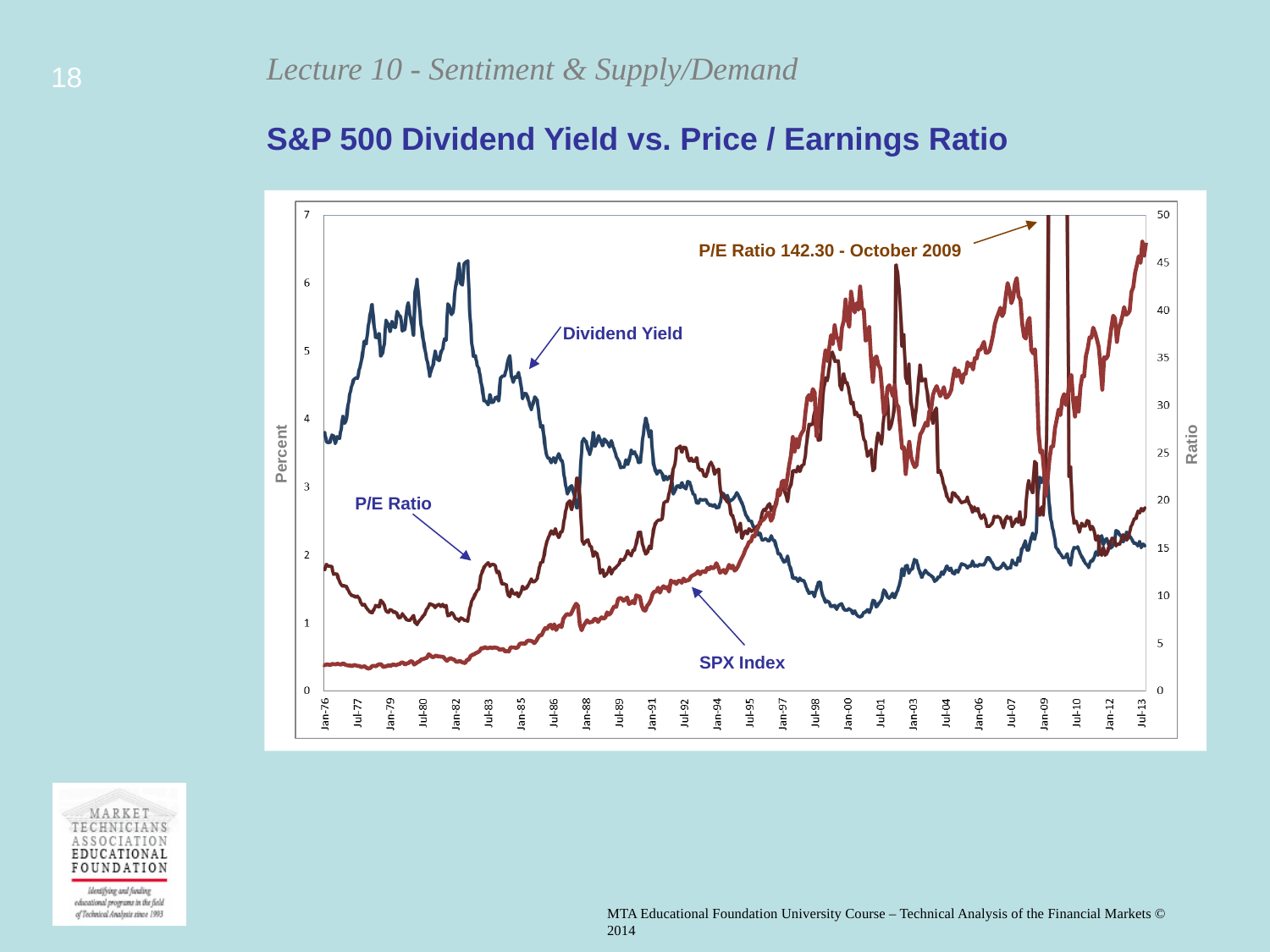
Is the P/E Ratio at Jan-76 greater or less than 20 on the Ratio axis? less What P/E Ratio value is annotated on the chart for October 2009? 142.30 Is the peak of the Dividend Yield around Jan-82 greater or less than 5 on the Percent axis? greater What is the title of the chart on the slide? S&P 500 Dividend Yield vs. Price / Earnings Ratio Does the SPX Index line generally rise or fall from Jan-76 to Jul-13? rise Does the Dividend Yield end at Jul-13 higher or lower than it starts at Jan-76? lower How many data series are plotted on the chart? 3 Is the Dividend Yield at Jan-76 greater or less than 3 on the Percent axis? greater What is the label of the left vertical axis? Percent Which series reaches the highest point on the chart? P/E Ratio What type of chart is shown on the slide? line chart